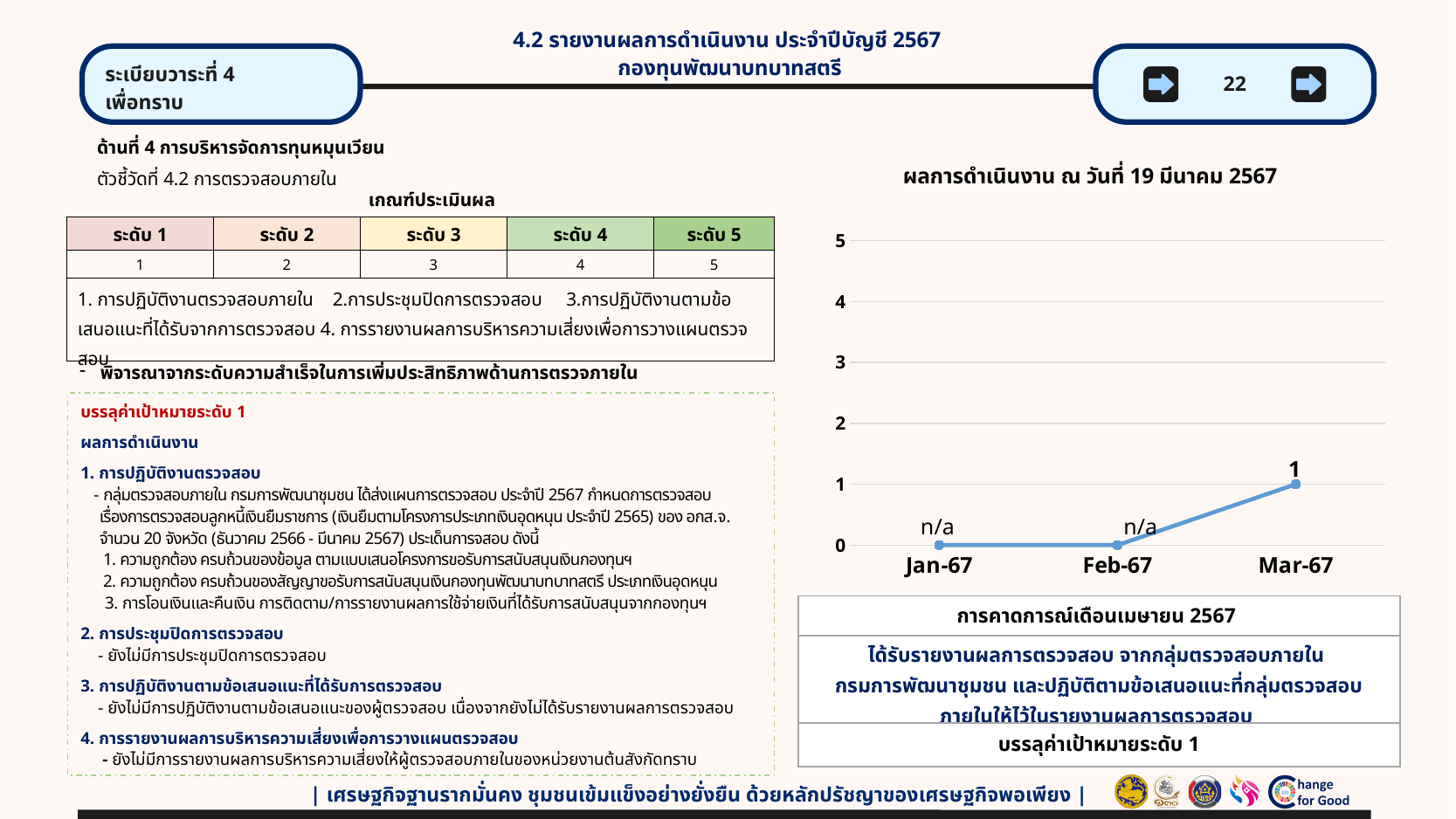
What kind of chart is shown on the slide? line chart What is the highest tick value shown on the y axis of the line chart? 5 What label is shown for Feb-67 in the line chart? n/a Does the line rise or fall from Feb-67 to Mar-67? rise Which month has the highest plotted value in the line chart? Mar-67 What is the title shown above the line chart? ผลการดำเนินงาน ณ วันที่ 19 มีนาคม 2567 Is the plotted value for Mar-67 greater or less than 2? less Which is plotted higher in the line chart, Feb-67 or Mar-67? Mar-67 What label is shown for Jan-67 in the line chart? n/a How many points are plotted along the x axis of the line chart? 3 What value is labelled for Mar-67 in the line chart? 1